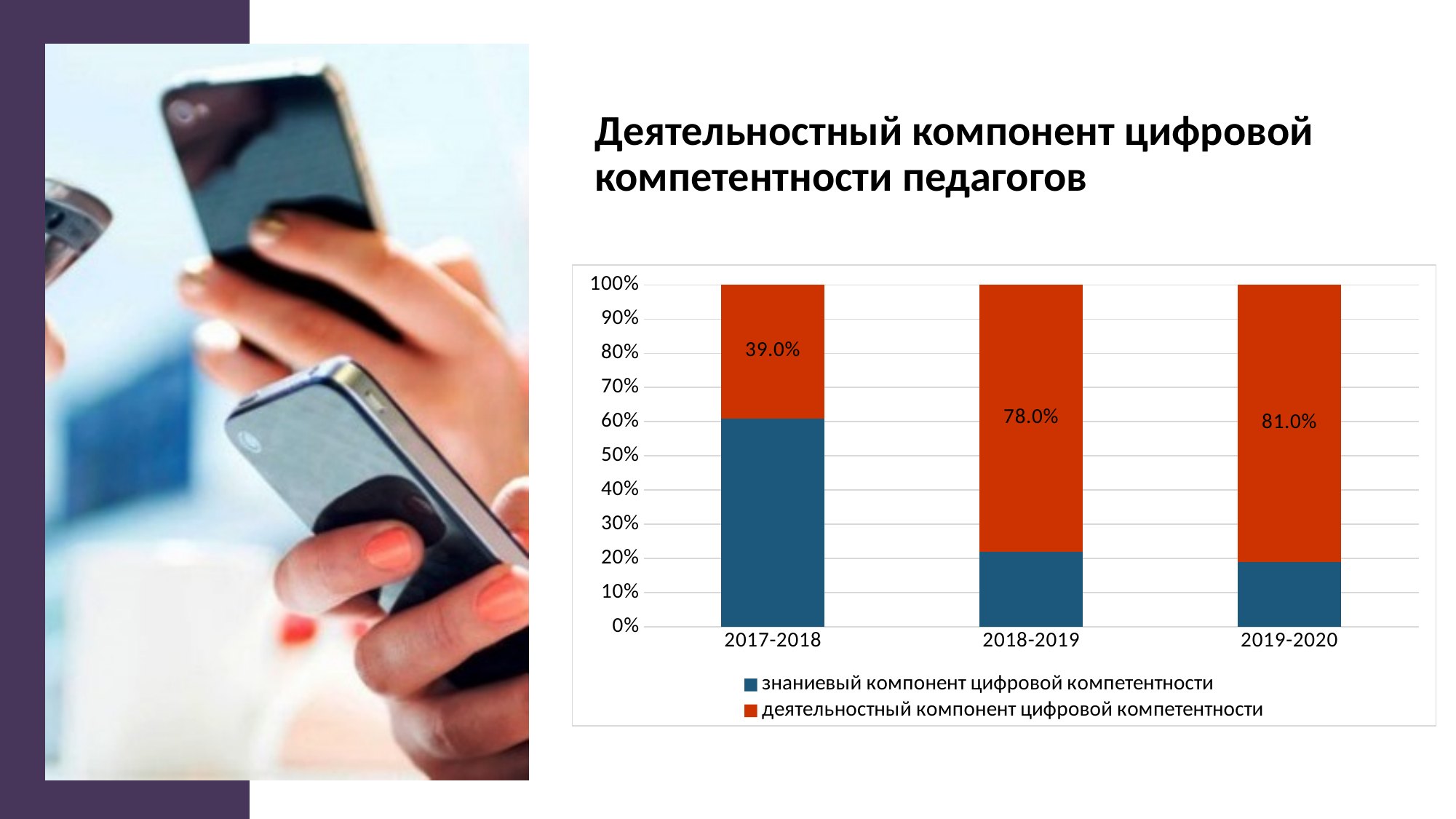
In which period is the деятельностный компонент цифровой компетентности value lowest? 2017-2018 How many series does the chart legend list? 2 What is the difference between the деятельностный компонент values for 2019-2020 and 2017-2018? 42.0% What is the value of the деятельностный компонент цифровой компетентности series for 2017-2018? 39.0% What is the value of the деятельностный компонент цифровой компетентности series for 2019-2020? 81.0% What is the value of the деятельностный компонент цифровой компетентности series for 2018-2019? 78.0% Is the value of the знаниевый компонент цифровой компетентности series for 2019-2020 greater or less than 30%? less Which is larger: the деятельностный компонент value for 2018-2019 or for 2017-2018? 2018-2019 What kind of chart is shown on the slide? Stacked bar chart Is the value of the знаниевый компонент цифровой компетентности series for 2017-2018 greater or less than 50%? greater In which period is the деятельностный компонент цифровой компетентности value highest? 2019-2020 How many periods are shown on the x axis of the chart? 3